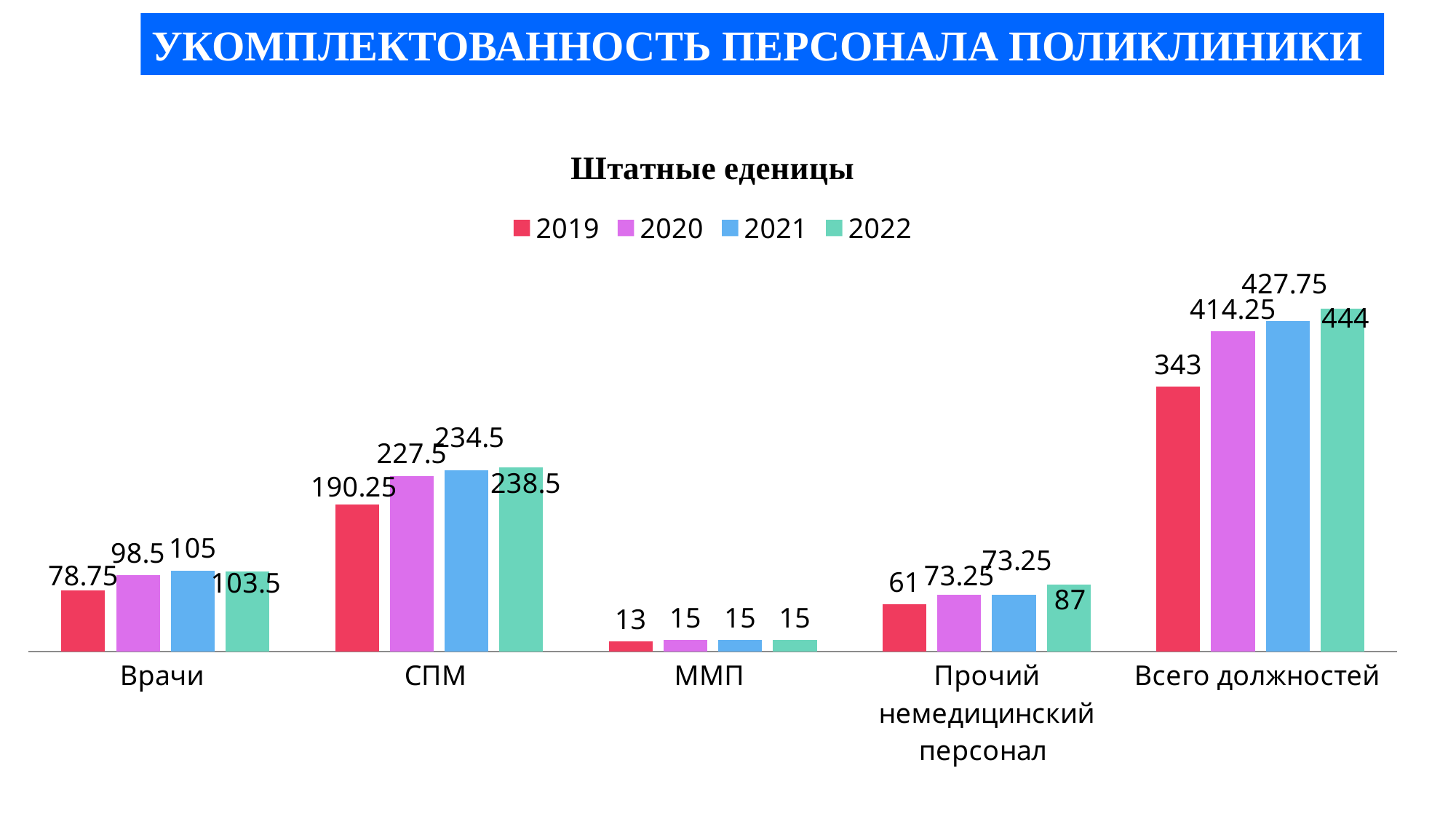
Which year has the highest value for Всего должностей? 2022 Which is larger for Врачи: the 2021 value or the 2022 value? 2021 How many categories are shown on the x axis? 5 What is the difference between the 2022 and 2019 values for Всего должностей? 101 What is the value for Врачи in 2019? 78.75 What type of chart is shown? bar chart What is the value for СПМ in 2022? 238.5 What is the value for Прочий немедицинский персонал in 2022? 87 How many series does the legend list? 4 What is the difference between the 2021 and 2020 values for Врачи? 6.5 Which category has the lowest value in 2019? ММП What is the value for Всего должностей in 2021? 427.75